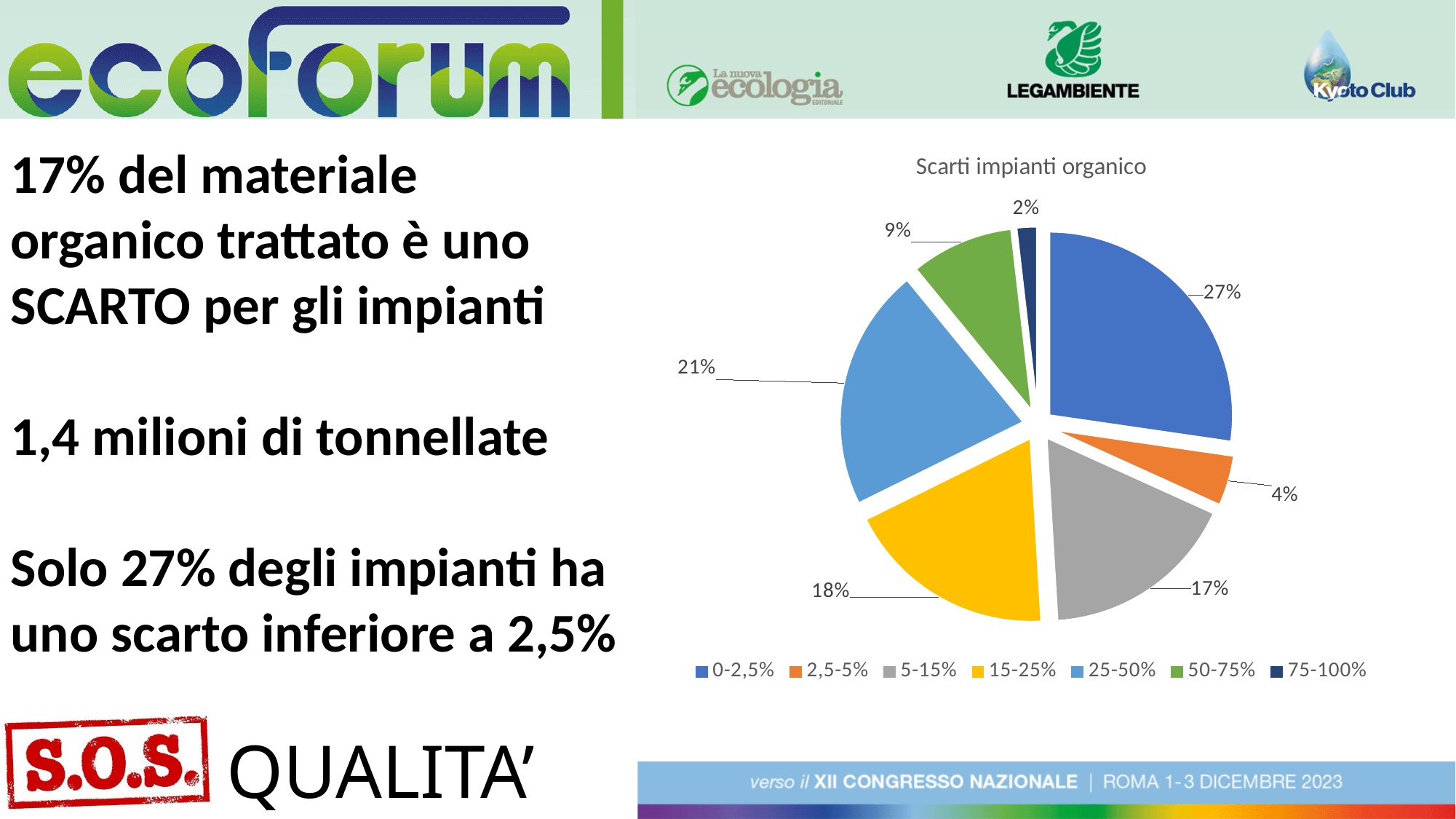
Which has a larger share, the 15-25% category or the 5-15% category? 15-25% What is the title of the pie chart? Scarti impianti organico What share of the pie does the 75-100% category have? 2% What share of the pie does the 0-2,5% category have? 27% What type of chart is shown on the slide? pie chart What share of the pie does the 5-15% category have? 17% Which category has the smallest slice of the pie? 75-100% How many slices does the pie chart have? 7 Which category has the largest slice of the pie? 0-2,5% What is the difference between the shares of the 25-50% and 50-75% categories? 12%